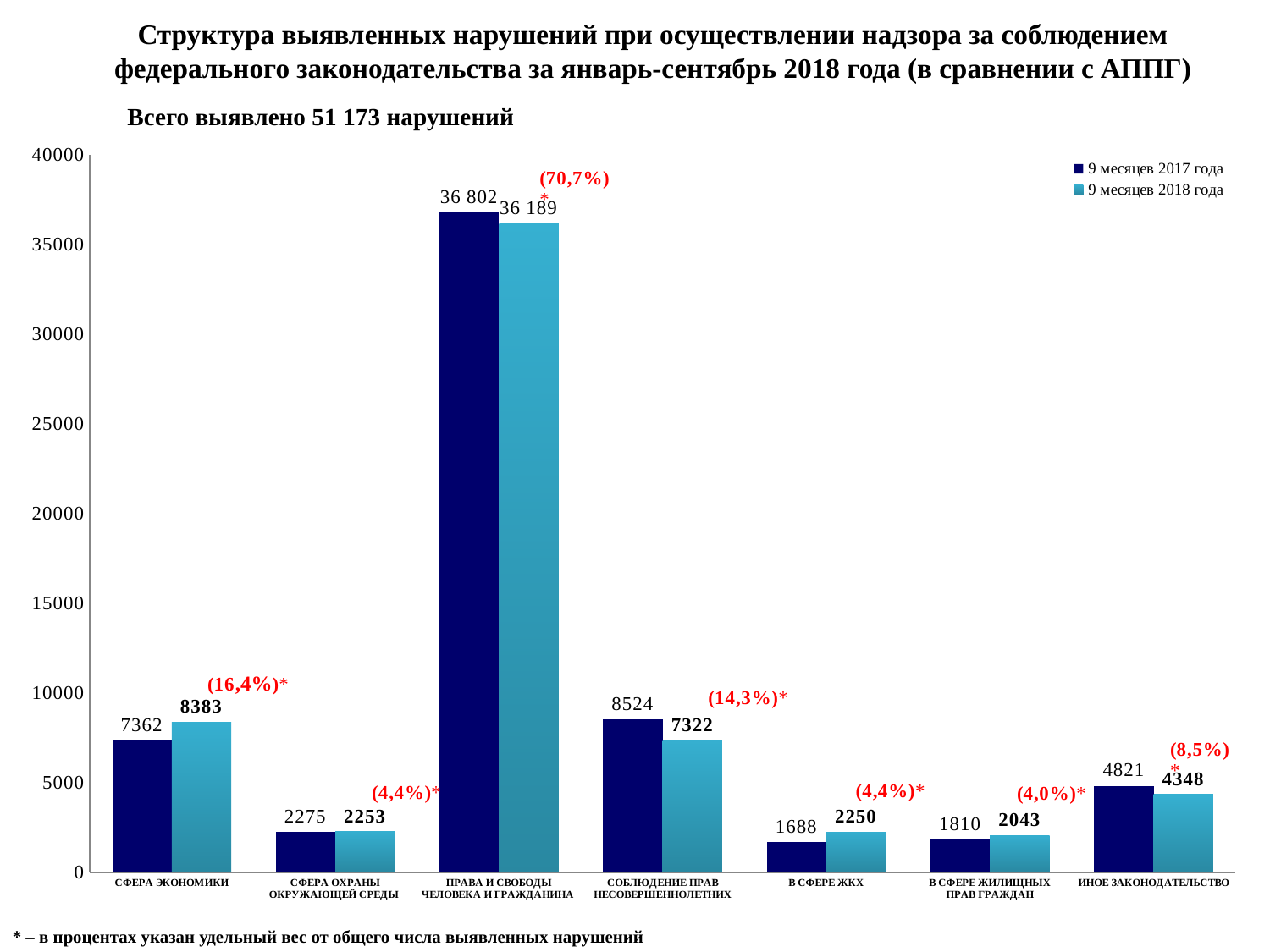
Which category has the lowest value in the 9 месяцев 2017 года series? В сфере ЖКХ What is the value for Сфера экономики in the 9 месяцев 2018 года series? 8383 Which is larger for Иное законодательство: the 9 месяцев 2017 года value or the 9 месяцев 2018 года value? 9 месяцев 2017 года Is the 9 месяцев 2018 года value for Сфера экономики greater or less than 5000? greater What total number of violations is stated above the chart (Всего выявлено)? 51 173 What is the difference between the 9 месяцев 2017 года and 9 месяцев 2018 года values for Соблюдение прав несовершеннолетних? 1202 How many series does the legend list? 2 What is the value for Права и свободы человека и гражданина in the 9 месяцев 2017 года series? 36 802 What kind of chart is shown on the slide? bar chart How many categories are shown on the x axis? 7 Which category has the highest value in the 9 месяцев 2018 года series? Права и свободы человека и гражданина What is the value for В сфере ЖКХ in the 9 месяцев 2018 года series? 2250